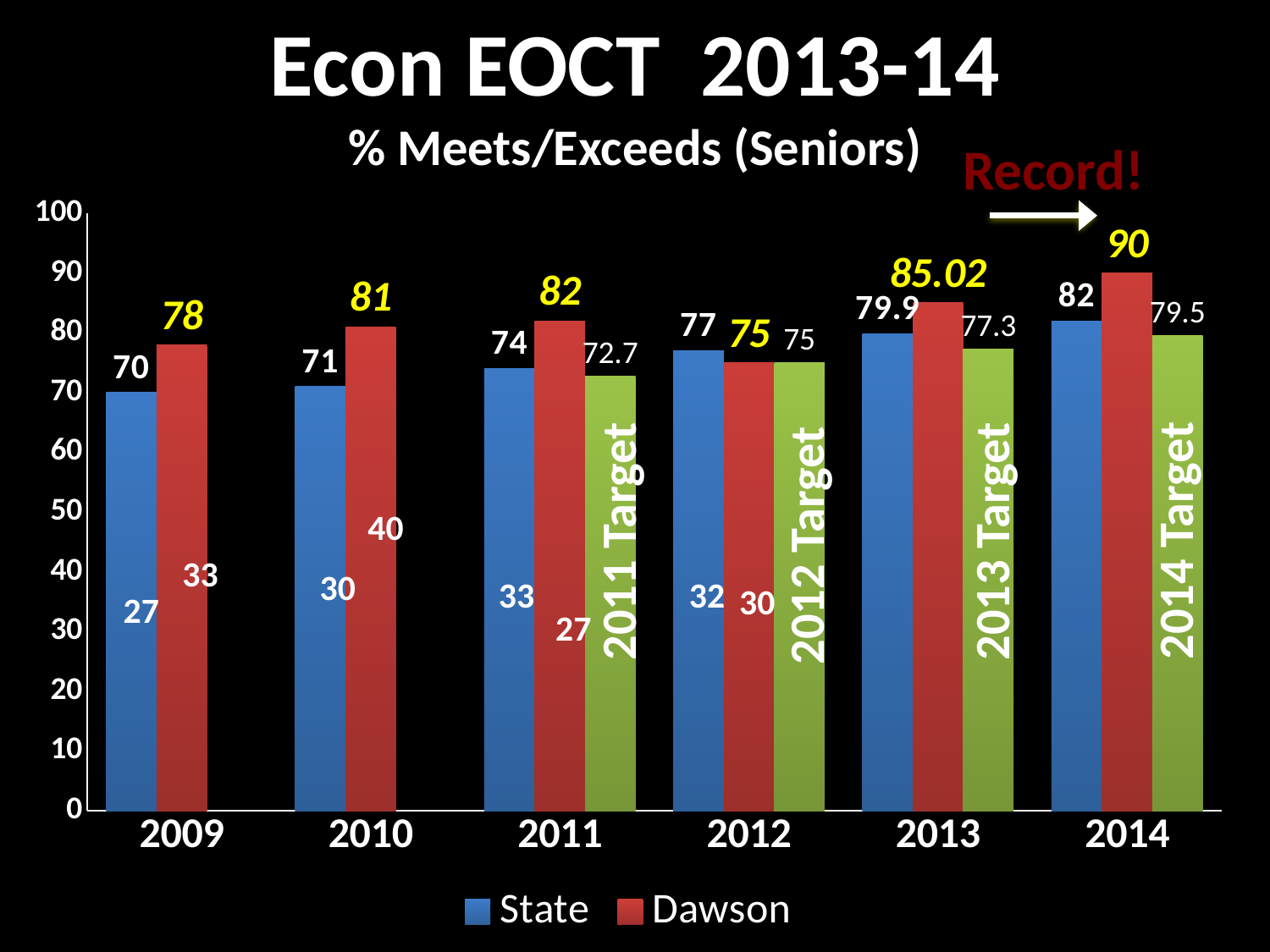
In which year is the State value lowest? 2009 What kind of chart is shown on the slide? Bar chart What is the State value for 2013? 79.9 Do the State values rise or fall from 2009 to 2014? Rise How many years are shown on the x axis? 6 What is the Dawson value for 2014? 90 How many series does the legend list? 2 What is the difference between the Dawson and State values in 2014? 8 What is the value of the 2012 Target bar? 75 Which is larger in 2012, the State value or the Dawson value? State What is the Dawson value for 2013? 85.02 In which year is the Dawson value highest? 2014